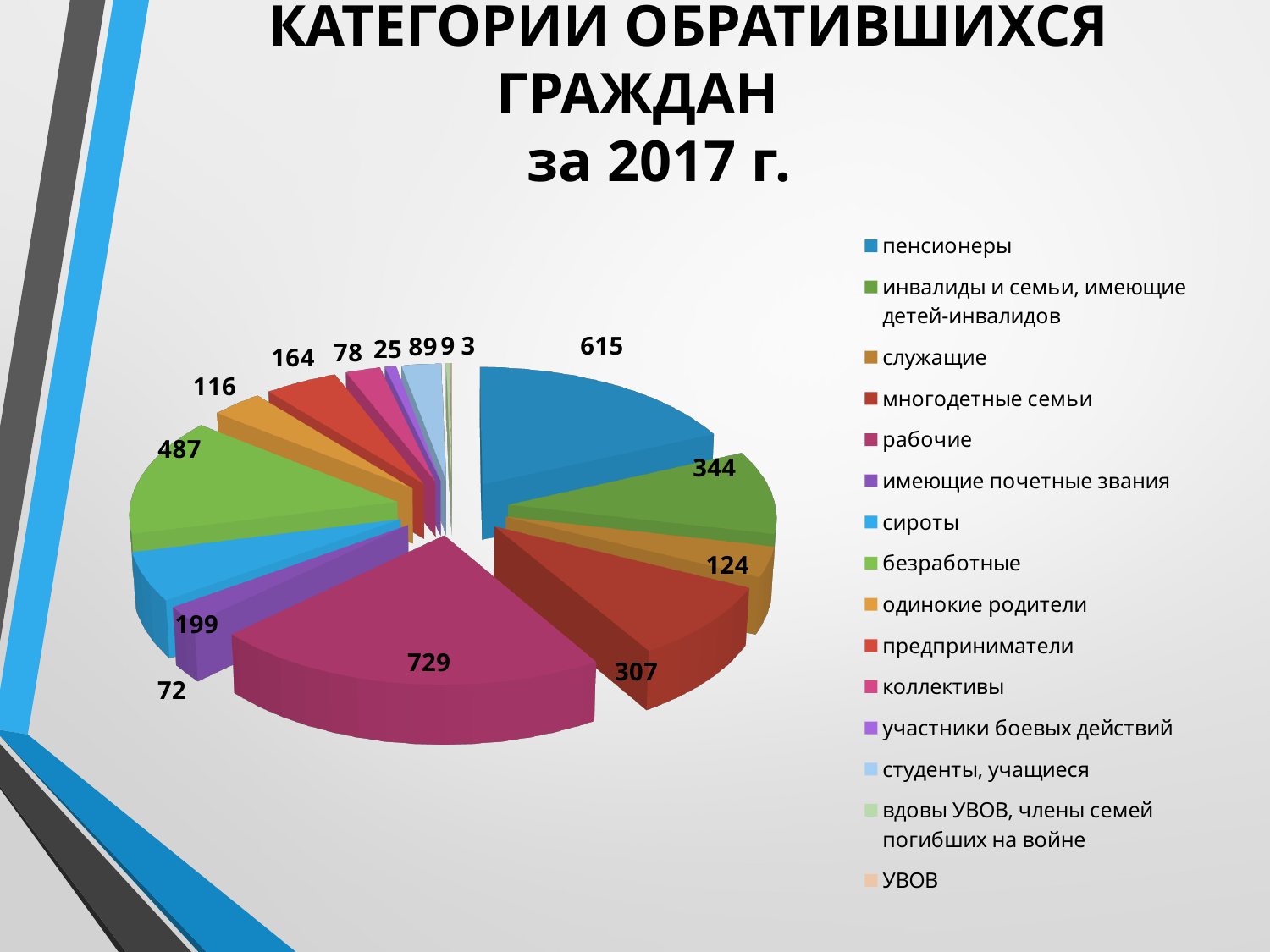
What is the value for многодетные семьи? 307 Which category has the lowest value? УВОВ What is the value for УВОВ? 3 What is the value for пенсионеры? 615 What is the title of the chart? КАТЕГОРИИ ОБРАТИВШИХСЯ ГРАЖДАН за 2017 г. What is the value for рабочие? 729 What is the difference between the values for рабочие and пенсионеры? 114 Which is larger, the value for инвалиды и семьи, имеющие детей-инвалидов or the value for многодетные семьи? инвалиды и семьи, имеющие детей-инвалидов How many categories does the legend list? 15 What is the value for безработные? 487 Which category has the highest value? рабочие What type of chart is shown on the slide? pie chart